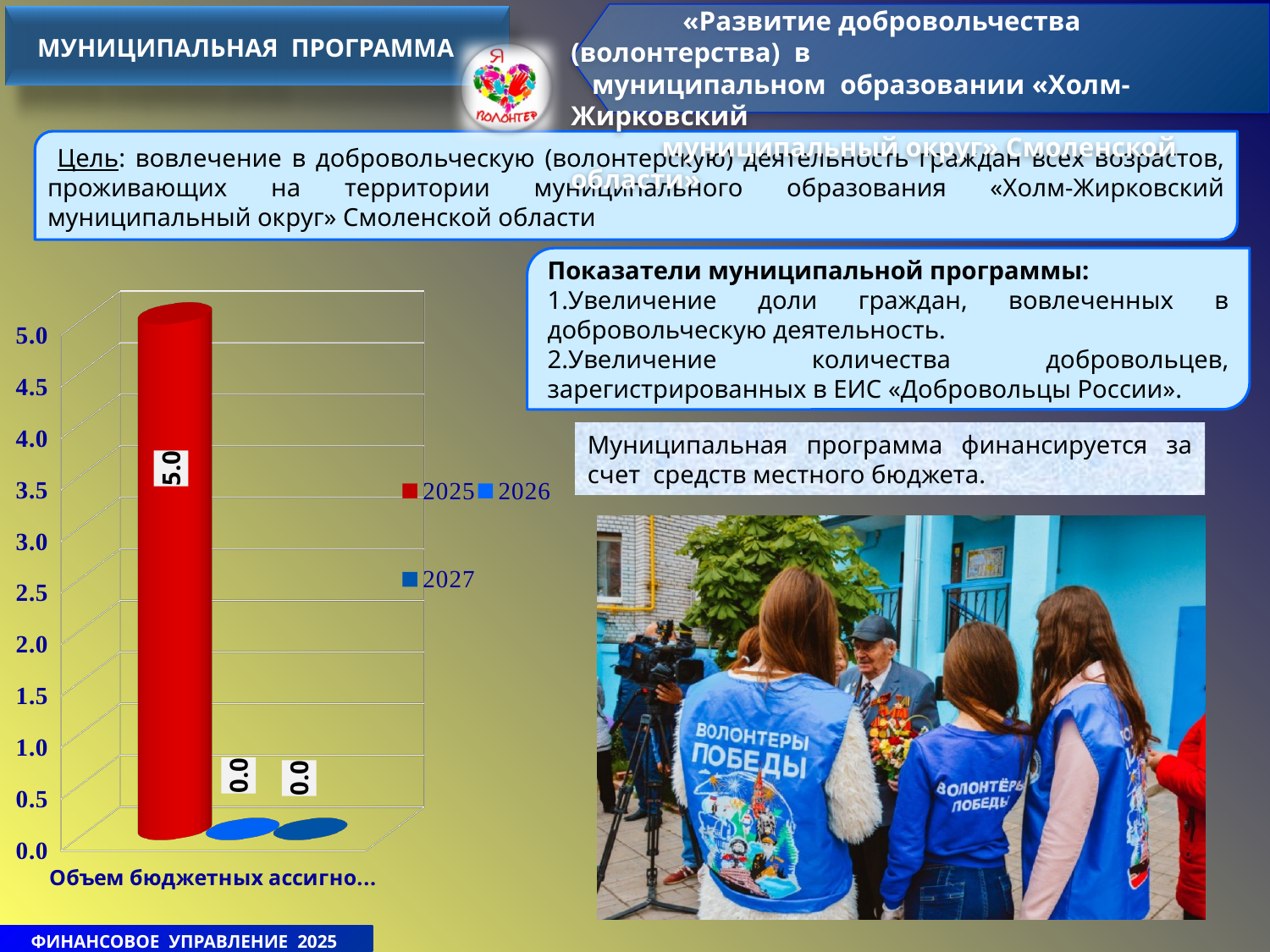
What kind of chart is shown on the left of the slide? bar chart Which is larger in the bar chart, the value for 2025 or the value for 2027? 2025 What is the value for 2027 in the bar chart? 0.0 What is the value for 2025 in the bar chart? 5.0 What is the value for 2026 in the bar chart? 0.0 How many series does the legend of the bar chart list? 3 Is the value for 2025 in the bar chart greater or less than 4.0? greater What is the difference between the values for 2025 and 2026 in the bar chart? 5.0 Which year has the highest value in the bar chart? 2025 What is the highest value shown on the vertical axis of the bar chart? 5.0 What colour is the bar for 2025 in the bar chart? red What is the total of the values for 2025, 2026 and 2027 in the bar chart? 5.0